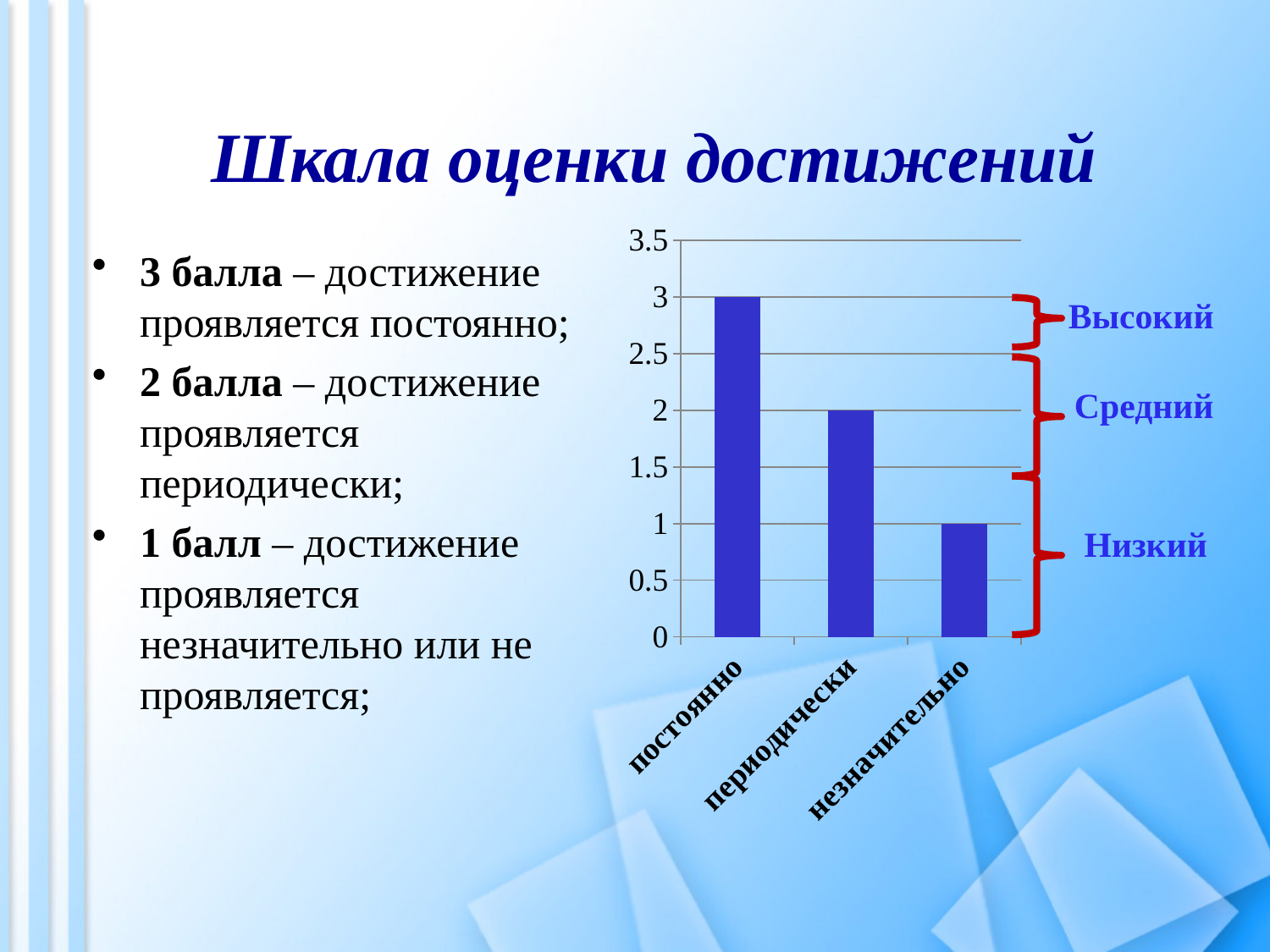
What is the value of the bar for "периодически"? 2 Which category has the highest bar? постоянно Which category has the lowest bar? незначительно What kind of chart is shown on the slide? bar chart What is the difference between the values for "постоянно" and "незначительно"? 2 What is the value of the bar for "незначительно"? 1 What is the highest value shown on the vertical axis of the chart? 3.5 Is the value for "периодически" greater or less than 2.5? less Do the bar values rise or fall from left to right along the x axis? fall How many categories are shown on the x axis of the chart? 3 Which is larger, the value for "периодически" or the value for "незначительно"? периодически What is the value of the bar for "постоянно"? 3